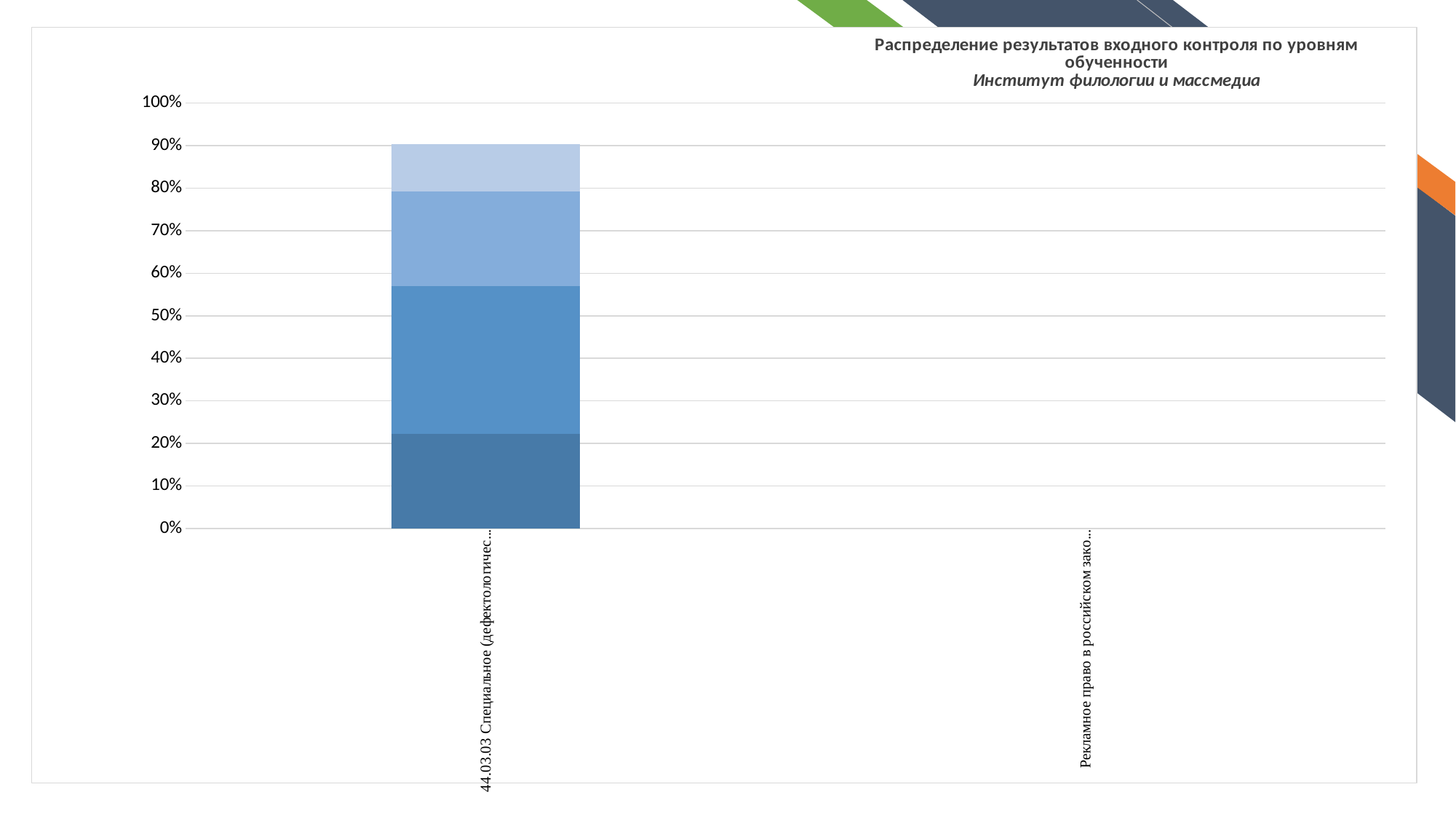
What kind of chart is shown on the slide? Stacked bar chart Which institute is named in the chart's subtitle? Институт филологии и массмедиа What is the title of the chart? Распределение результатов входного контроля по уровням обученности Институт филологии и массмедиа How many stacked segments make up the bar for 44.03.03 Специальное (дефектологичес...? 4 Is the total height of the stacked bar for 44.03.03 Специальное (дефектологичес... greater or less than 100%? less Is the bottom (darkest) segment of the bar for 44.03.03 Специальное (дефектологичес... greater or less than 30%? less What is the highest value shown on the y axis? 100% Is the total height of the stacked bar for 44.03.03 Специальное (дефектологичес... greater or less than 80%? greater Which of the two x-axis categories has a visible bar plotted? 44.03.03 Специальное (дефектологичес... How many categories are labelled on the x axis of the chart? 2